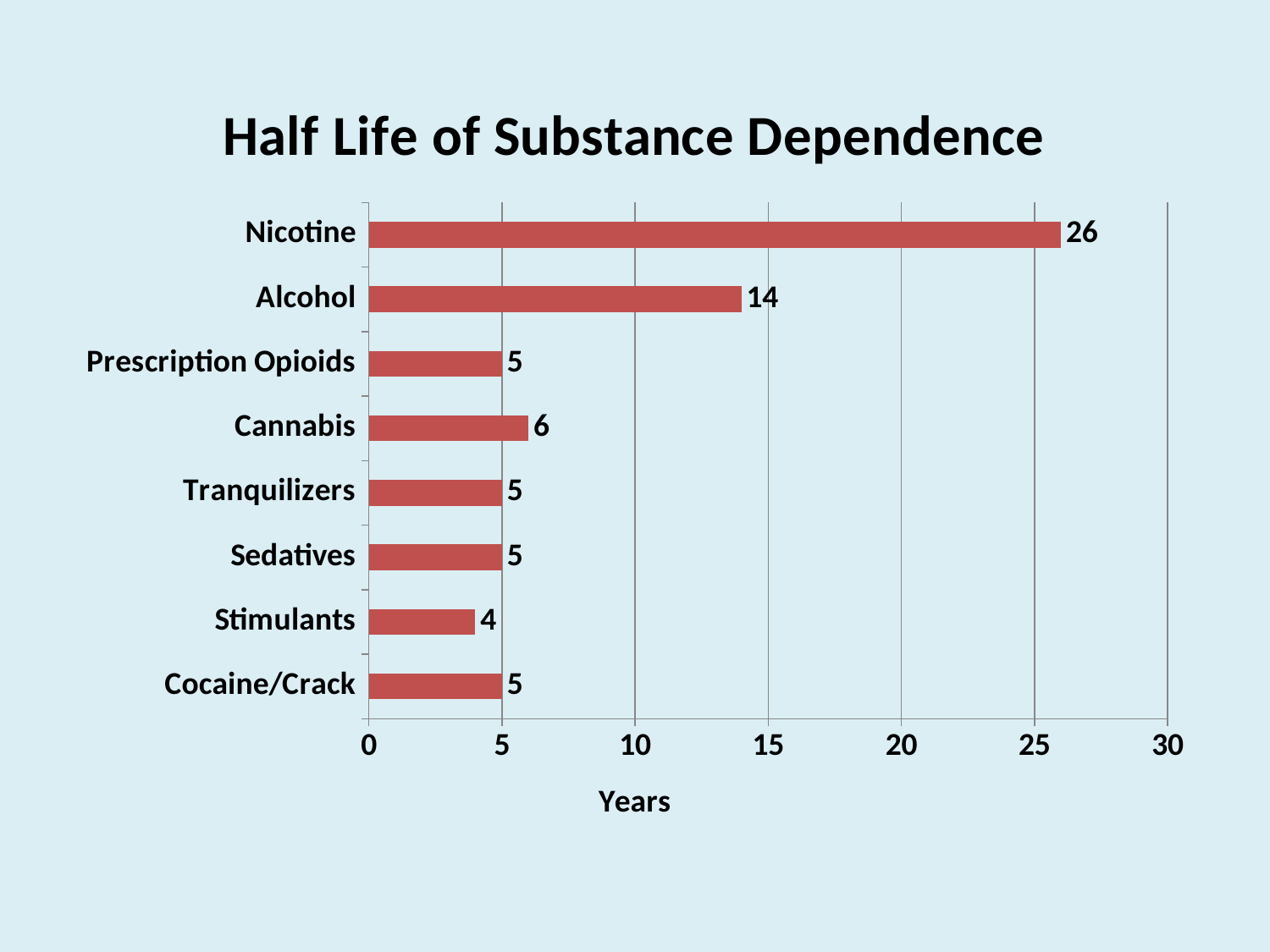
Is the value for Alcohol greater or less than 10? greater What is the difference in years between Nicotine and Alcohol? 12 What is the half life of substance dependence for Nicotine? 26 What is the value shown for Alcohol? 14 How many substances are shown in the chart? 8 Which substance has the highest half life of dependence? Nicotine What is the label of the horizontal axis? Years What is the value shown for Stimulants? 4 What kind of chart is shown on the slide? Bar chart What is the value shown for Cannabis? 6 Which substance has the lowest half life of dependence? Stimulants Which has a larger value, Cannabis or Prescription Opioids? Cannabis